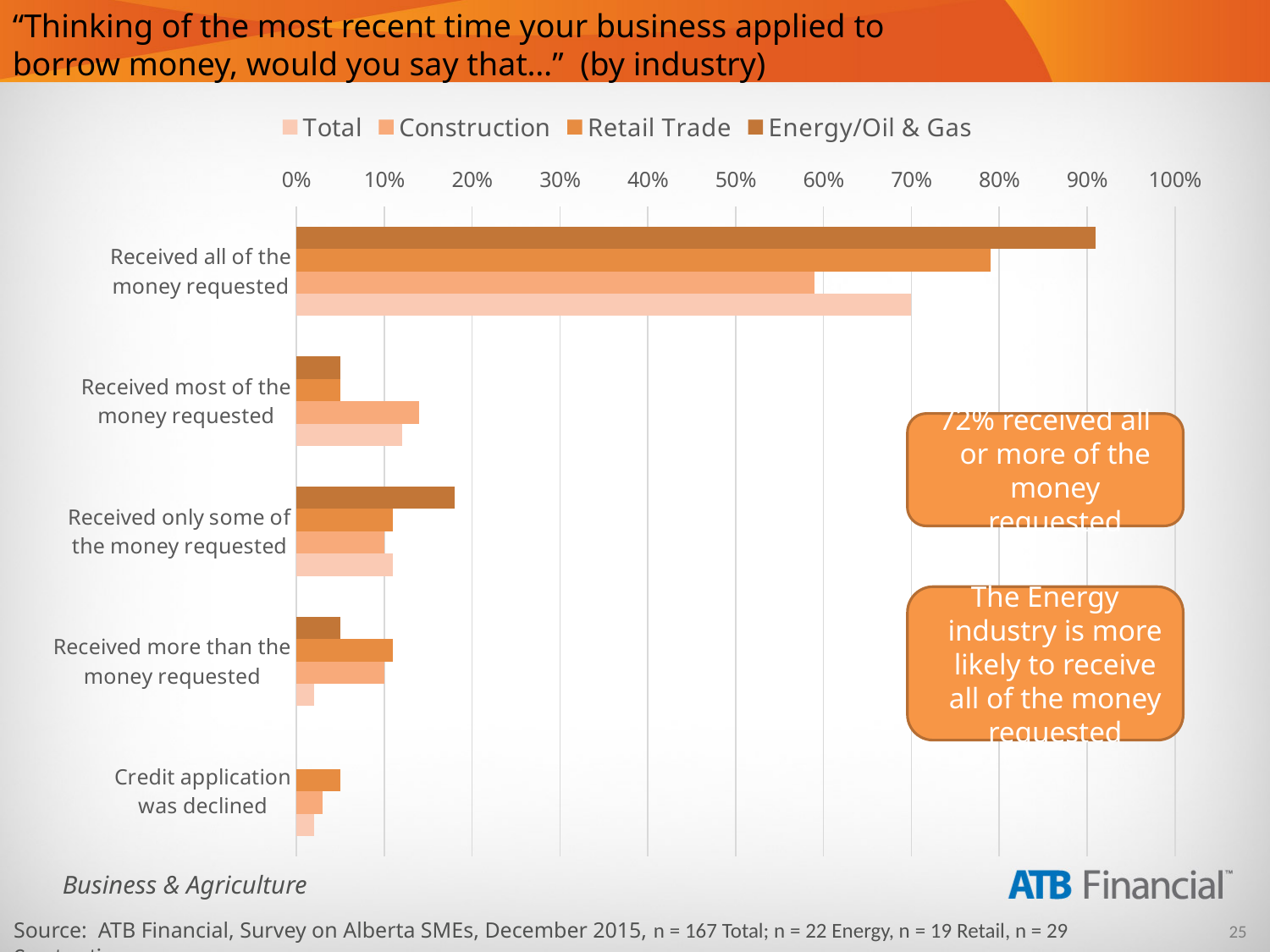
How many series does the legend list? 4 For "Received only some of the money requested", which is larger: Energy/Oil & Gas or Retail Trade? Energy/Oil & Gas Which response category has the highest Total value? Received all of the money requested Is the Total value for "Received all of the money requested" greater or less than 60%? greater Which industry has the highest value for "Received all of the money requested"? Energy/Oil & Gas Is the Total value for "Received more than the money requested" greater or less than 10%? less For "Received all of the money requested", which is larger: Retail Trade or Construction? Retail Trade Is the Energy/Oil & Gas value for "Received all of the money requested" greater or less than 80%? greater How many response categories are shown on the vertical axis? 5 What kind of chart is shown on the slide? bar chart